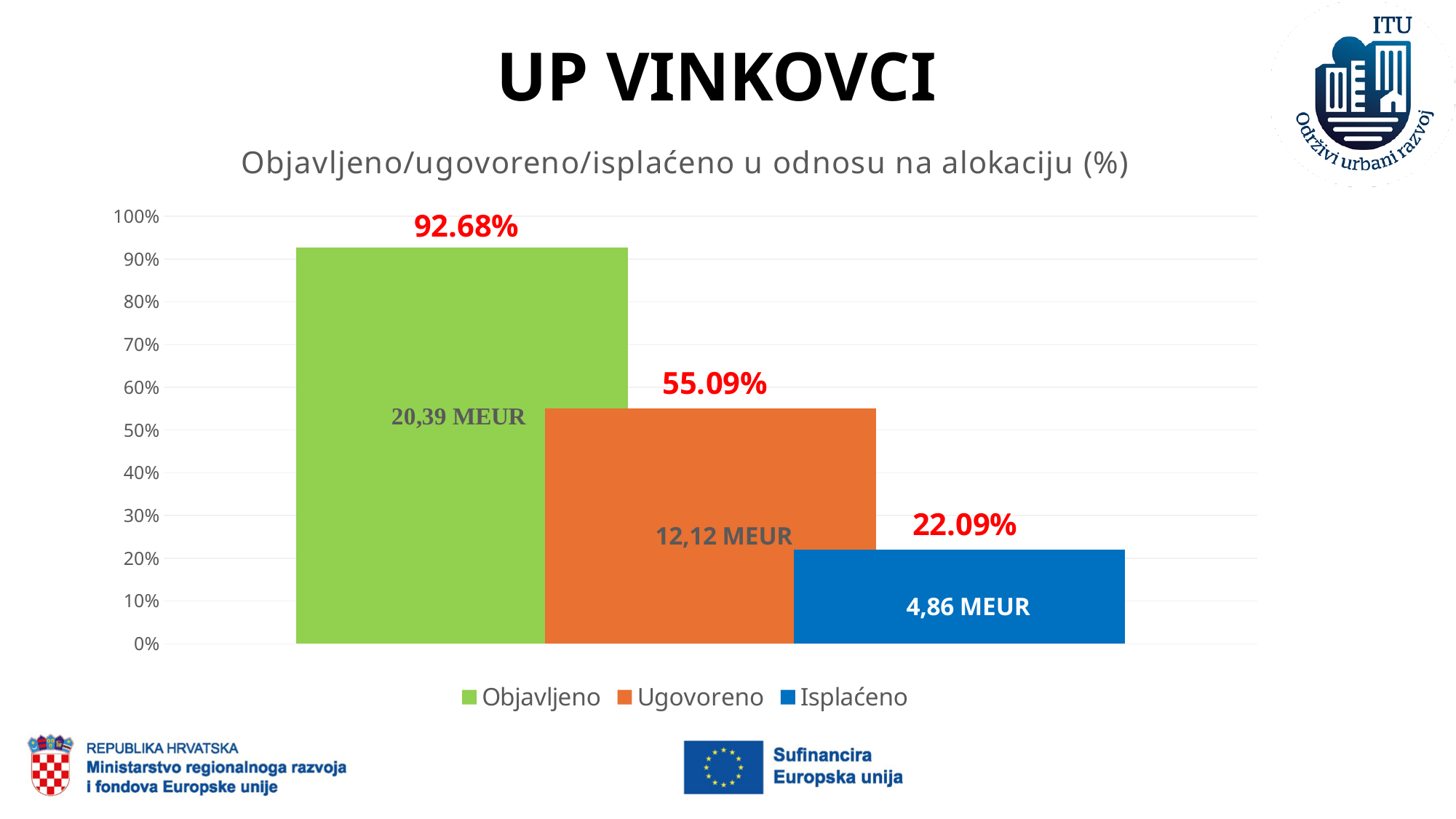
Which series has the highest percentage? Objavljeno What percentage value is shown for Isplaćeno? 22.09% What percentage value is shown for Objavljeno? 92.68% What amount in MEUR is labelled on the Ugovoreno bar? 12,12 MEUR What is the title of the chart? Objavljeno/ugovoreno/isplaćeno u odnosu na alokaciju (%) How many series does the legend list? 3 Which series has the lowest percentage? Isplaćeno What kind of chart is shown? bar chart What is the difference in percentage points between Objavljeno and Ugovoreno? 37.59 What amount in MEUR is labelled on the Isplaćeno bar? 4,86 MEUR What percentage value is shown for Ugovoreno? 55.09% Which is larger, the percentage for Ugovoreno or for Isplaćeno? Ugovoreno